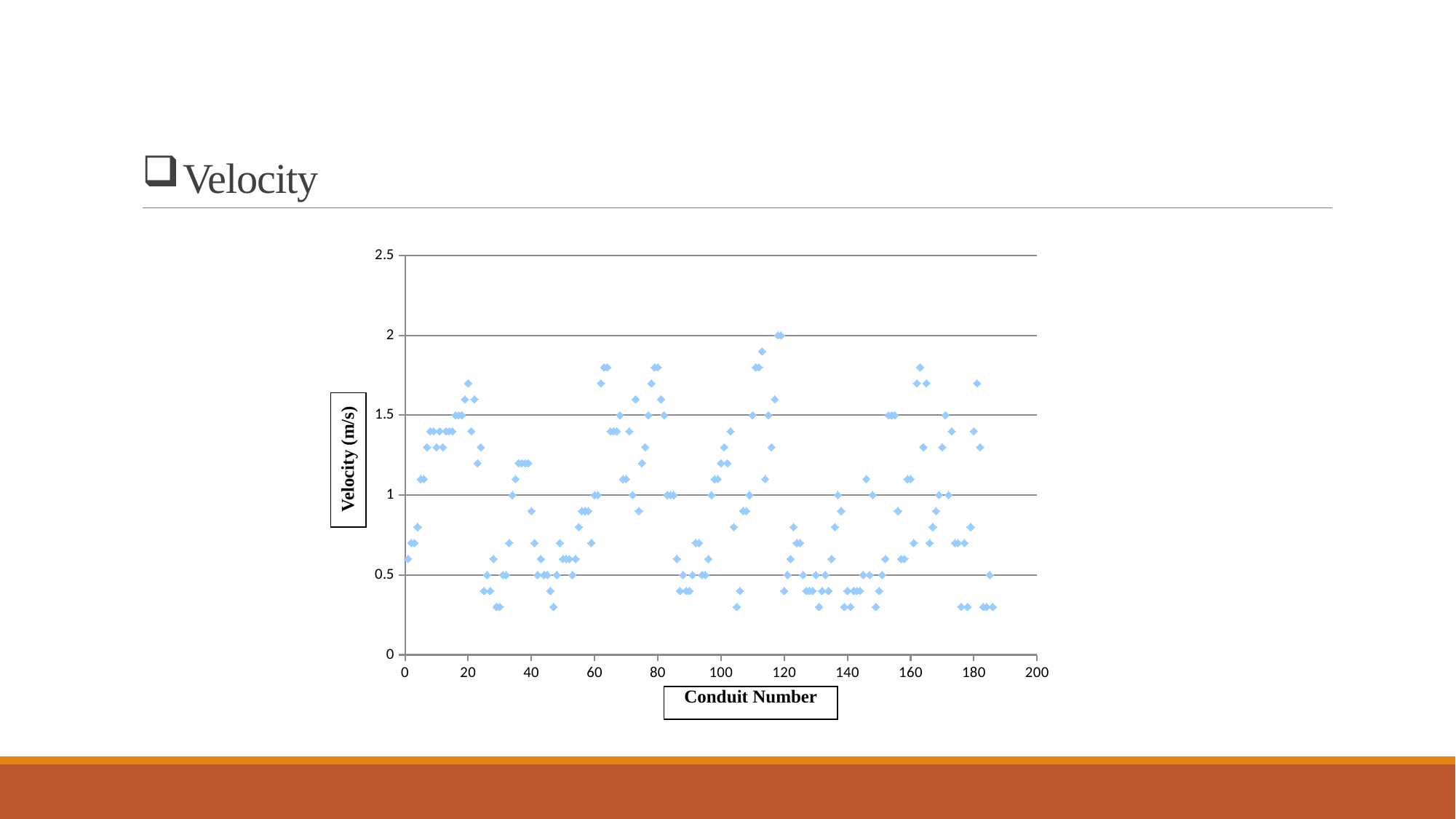
What is the maximum value shown on the vertical axis of the chart? 2.5 What is the highest velocity value plotted on the chart? 2 Is the highest velocity value on the chart greater or less than 2.5? less What is the title of the vertical axis of the chart? Velocity (m/s) What kind of chart is shown on the slide? scatter chart What is the maximum value shown on the horizontal axis of the chart? 200 What is the title of the horizontal axis of the chart? Conduit Number